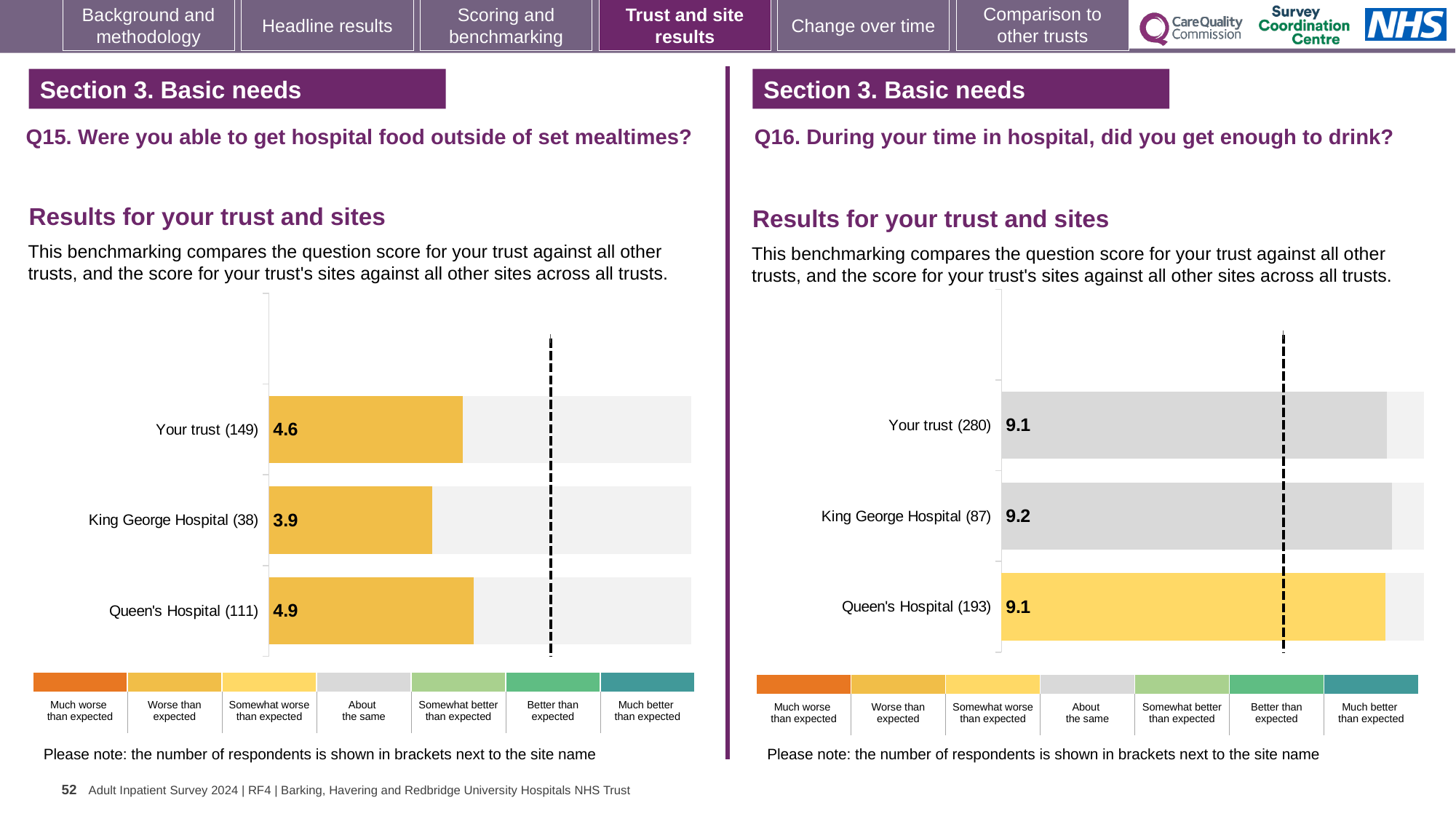
What type of chart is used on the Q15 chart (left)? Bar chart On the Q16 chart (right), which benchmarking category does the colour of the Queen's Hospital bar correspond to in the legend? Somewhat worse than expected On the Q16 chart (right), what is the score for Queen's Hospital? 9.1 On the Q15 chart (left), which site or trust row has the highest score? Queen's Hospital On the Q16 chart (right), how many respondents are shown in brackets for Your trust? 280 On the Q15 chart (left), is the score for Your trust larger or smaller than the score for King George Hospital? Larger On the Q15 chart (left), what is the score for King George Hospital? 3.9 On the Q16 chart (right), how many bars are plotted? 3 On the Q15 chart (left), which site or trust row has the lowest score? King George Hospital On the Q15 chart (left), what is the difference between the scores for Queen's Hospital and King George Hospital? 1.0 On the Q15 chart (left), what is the score for Your trust? 4.6 On the Q16 chart (right), what is the score for King George Hospital? 9.2